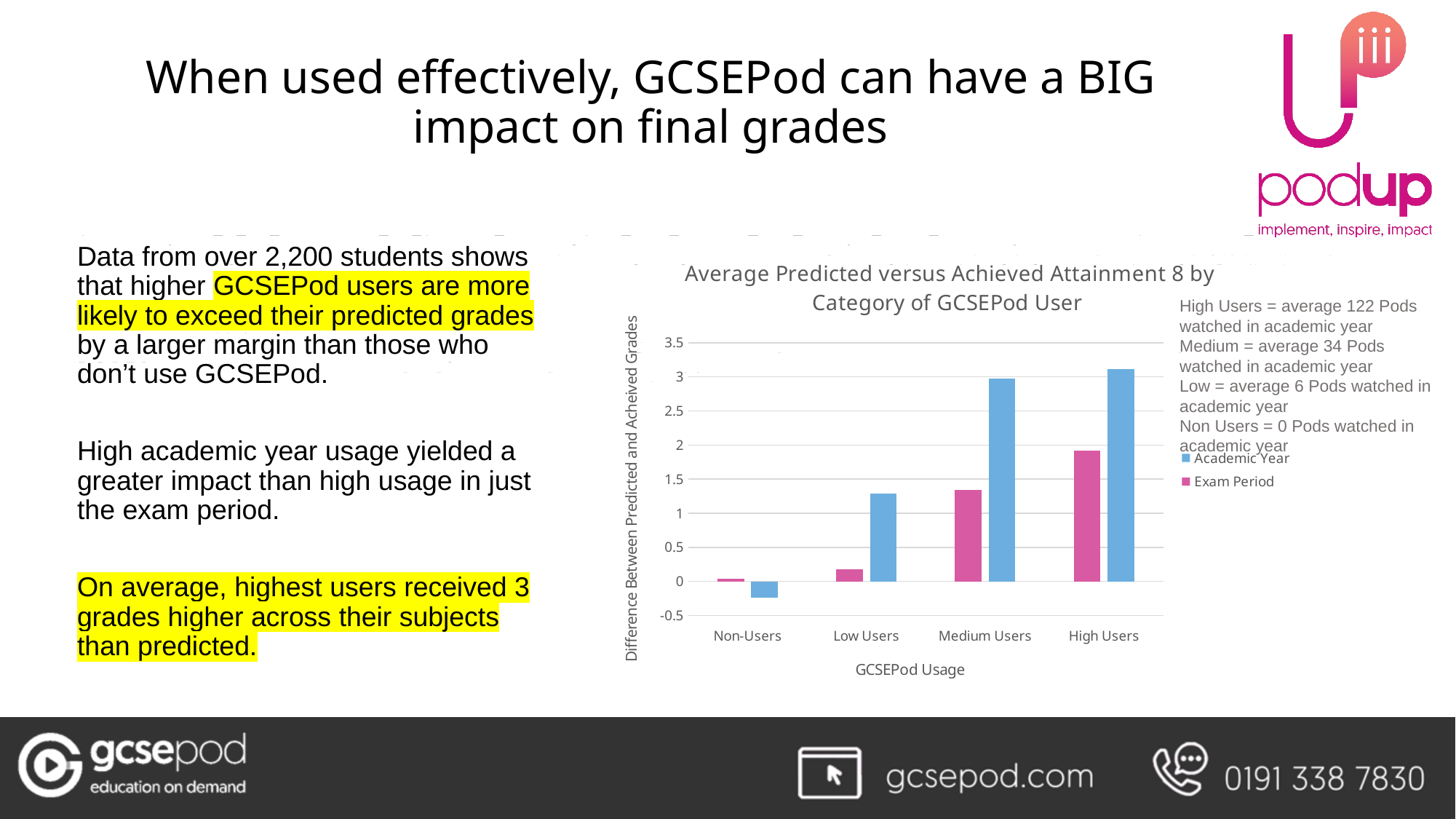
What is the label on the chart's y axis? Difference Between Predicted and Acheived Grades Which category has the highest Exam Period value? High Users How many categories of GCSEPod usage are shown on the x axis of the chart? 4 For Medium Users, which is larger: the Academic Year value or the Exam Period value? Academic Year How many series does the chart's legend list? 2 What type of chart is shown on the slide? Bar chart Is the Exam Period value for Low Users greater or less than 0.5? less Is the Academic Year value for Medium Users greater or less than 2? greater Is the Academic Year value for Non-Users greater or less than 0? less Do the Academic Year values rise or fall as usage moves from Non-Users to High Users? rise Which category has the lowest Academic Year value? Non-Users